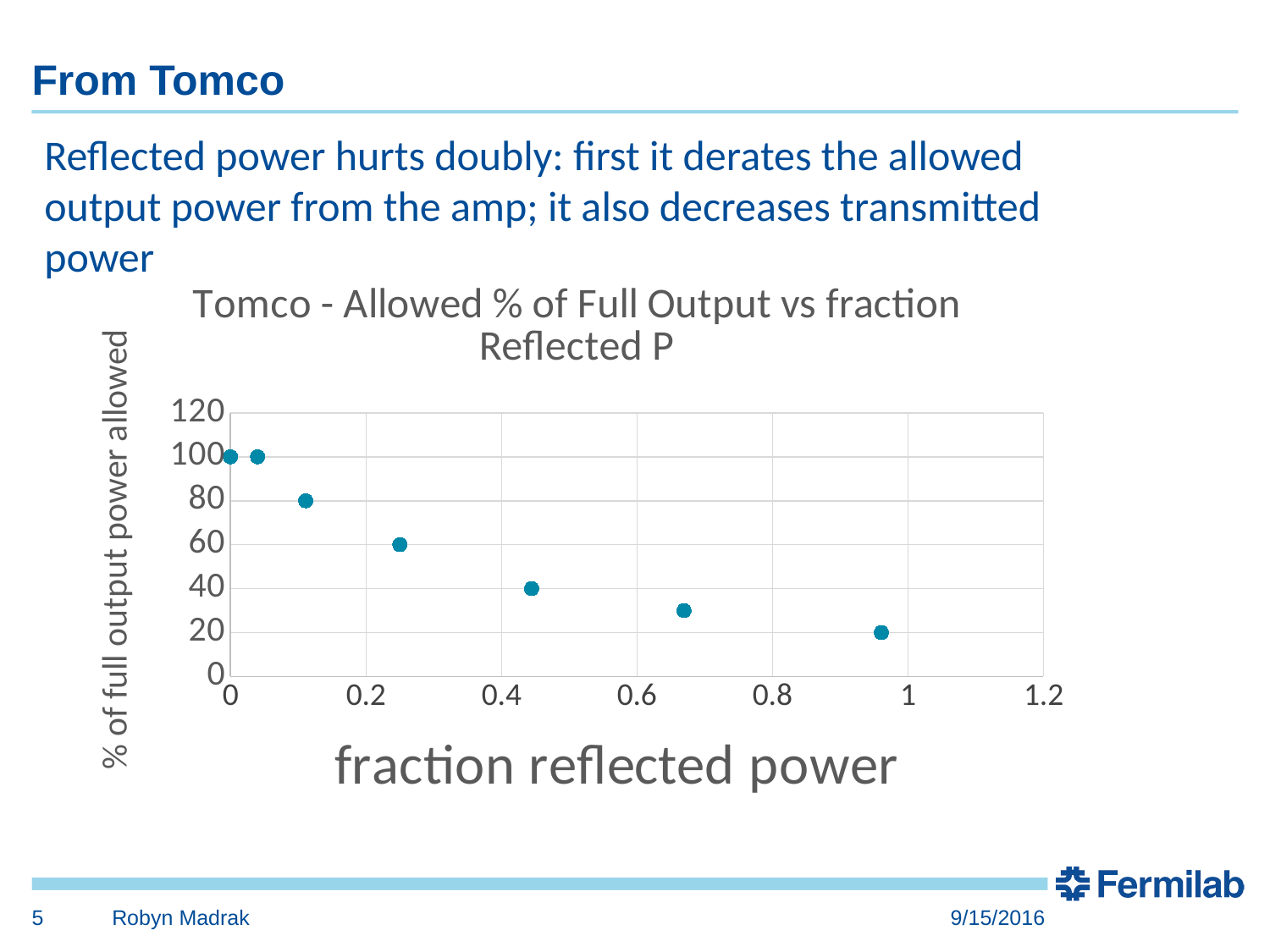
Do the plotted values rise or fall as fraction reflected power increases? fall What is the % of full output power allowed for the point at fraction reflected power 0? 100 What is the label of the x axis? fraction reflected power Is the % of full output power allowed for the point near fraction reflected power 0.25 greater or less than 80? less What is the % of full output power allowed for the rightmost point? 20 What is the title of the chart? Tomco - Allowed % of Full Output vs fraction Reflected P What kind of chart is shown on the slide? scatter chart Which has the higher % of full output power allowed: the point near fraction reflected power 0.44 or the point near 0.96? the point near 0.44 Is the % of full output power allowed for the point near fraction reflected power 0.11 greater or less than 60? greater Is the % of full output power allowed for the point near fraction reflected power 0.67 greater or less than 40? less How many data points are plotted in the chart? 7 Which point has the lowest % of full output power allowed? the rightmost point (near fraction reflected power 0.96)